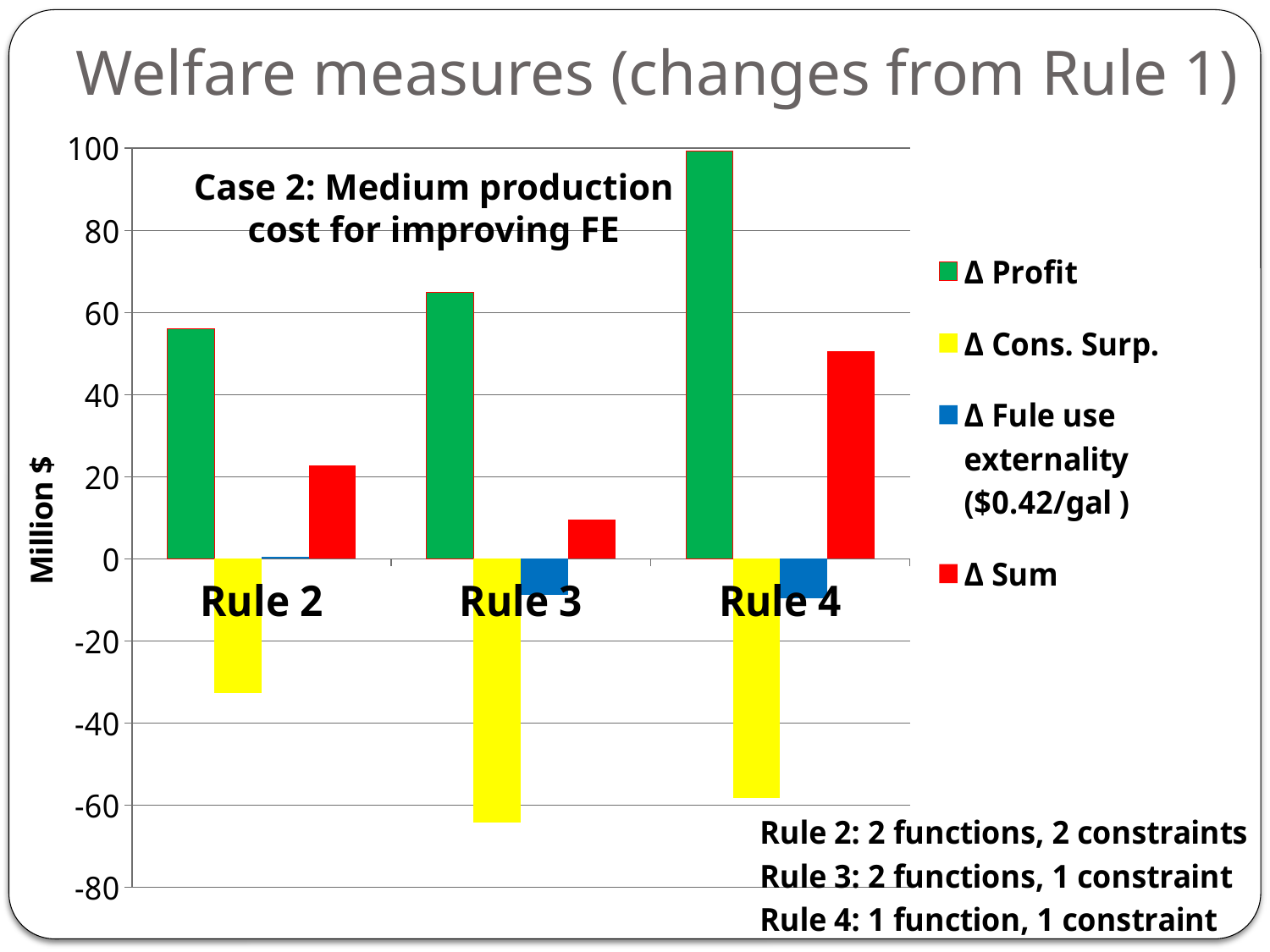
Does Δ Profit rise or fall from Rule 2 to Rule 4? rises Which rule has the lowest (most negative) Δ Cons. Surp.? Rule 3 Which is larger, the Δ Sum for Rule 2 or the Δ Sum for Rule 3? Rule 2 How many series does the legend list? 4 Which rule has the highest Δ Profit? Rule 4 Is the Δ Sum value for Rule 4 greater or less than 40? greater Which rule has the highest Δ Sum? Rule 4 What is the label on the vertical axis? Million $ Is the Δ Profit value for Rule 4 greater or less than 80? greater Is the Δ Cons. Surp. value for Rule 2 greater or less than -20? less What kind of chart is shown on the slide? bar chart How many rule categories are plotted on the x axis? 3